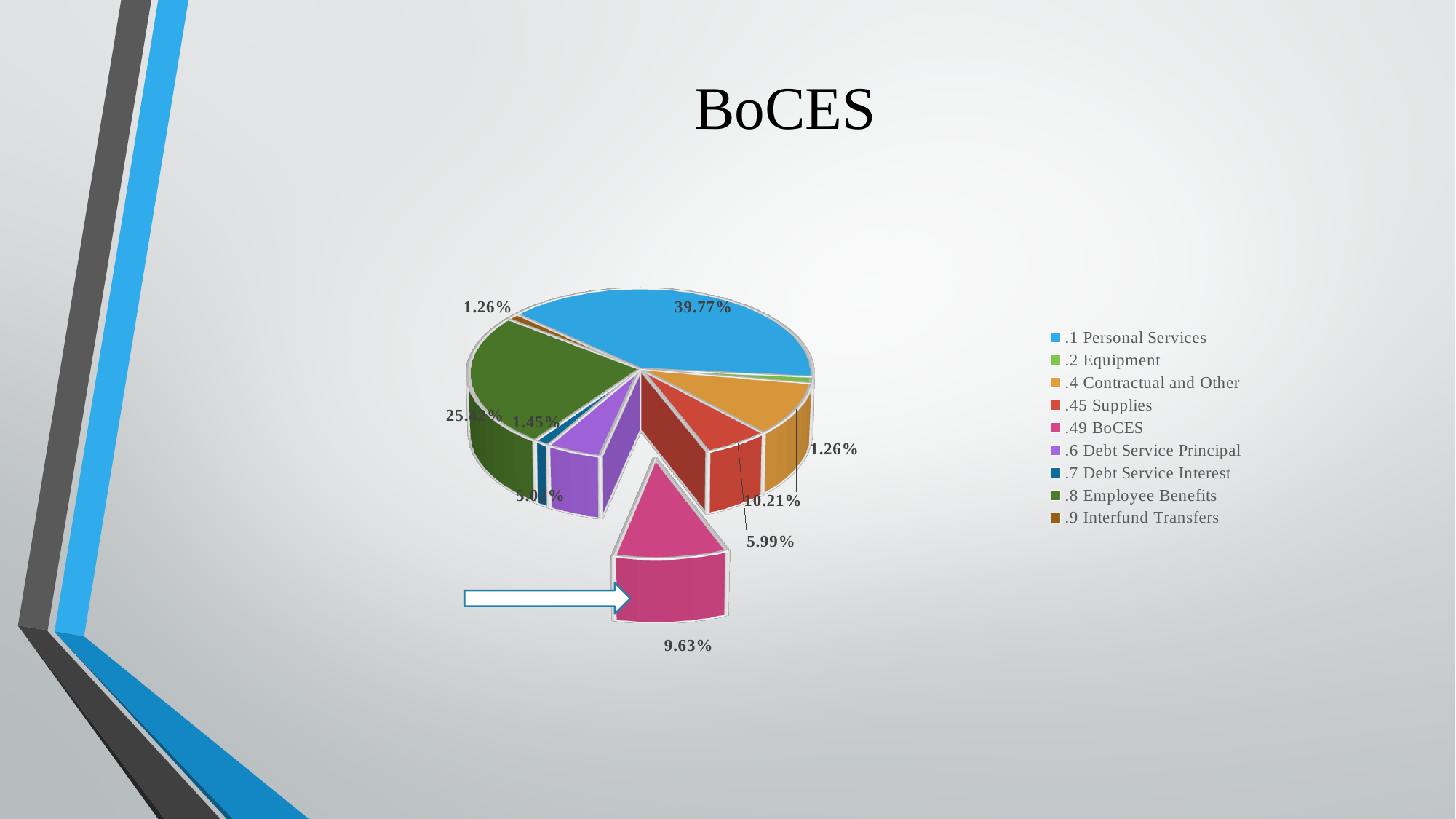
How many categories does the legend list? 9 What percentage is shown for .1 Personal Services? 39.77% What percentage is shown for .49 BoCES? 9.63% What is the title of the chart? BoCES What percentage is shown for .4 Contractual and Other? 10.21% Which has the larger share, .45 Supplies or .49 BoCES? .49 BoCES What kind of chart is shown on the slide? pie chart What percentage is shown for .45 Supplies? 5.99% What percentage is shown for .9 Interfund Transfers? 1.26% What percentage is shown for .7 Debt Service Interest? 1.45% Which category has the largest share of the pie? .1 Personal Services What is the difference between the shares of .1 Personal Services and .4 Contractual and Other? 29.56%